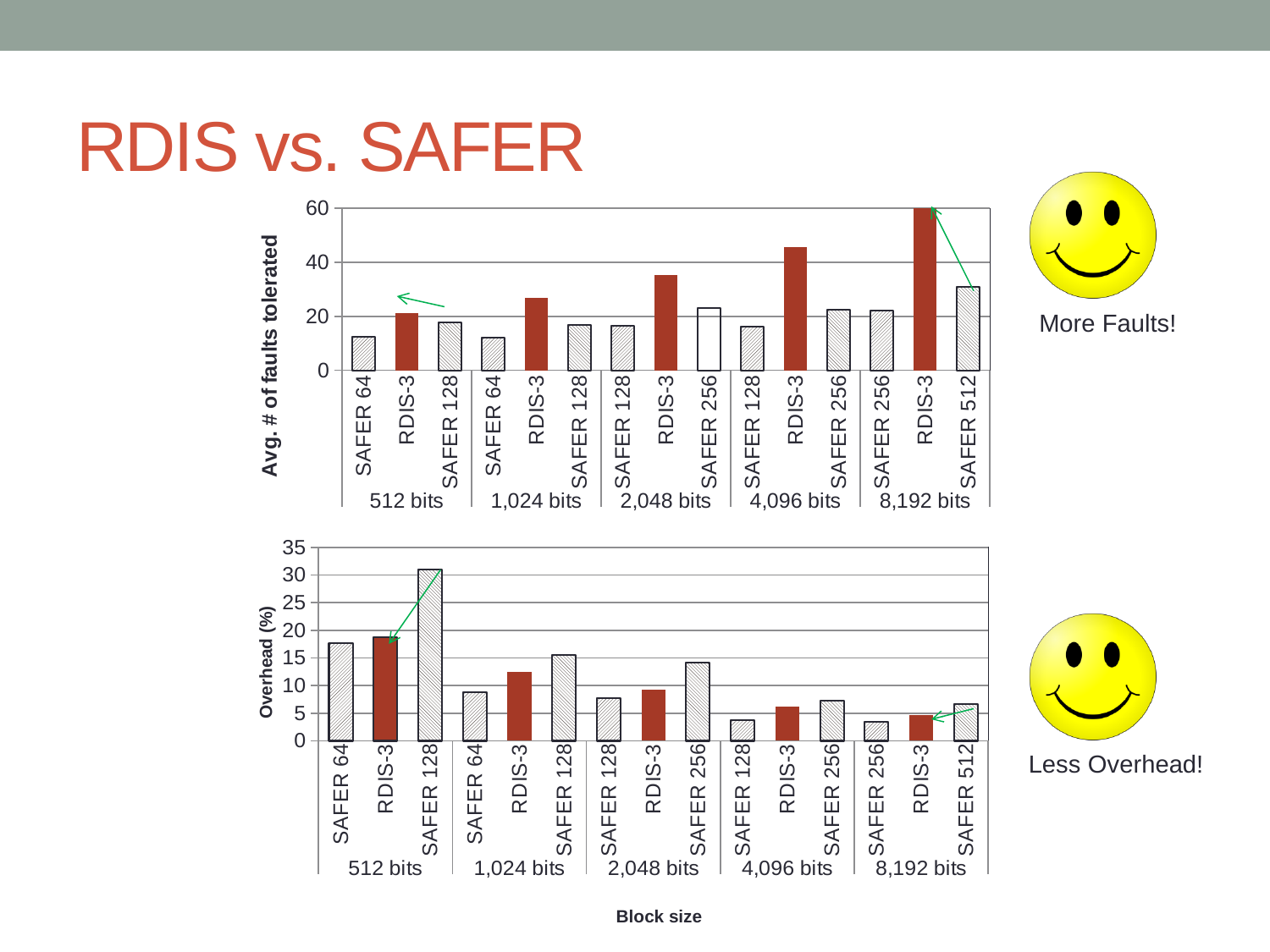
In the top chart (Avg. # of faults tolerated), is the value for SAFER 64 at 512 bits greater or less than 20? less In the top chart (Avg. # of faults tolerated), which bar is the highest? RDIS-3 at 8,192 bits In the bottom chart (Overhead (%)), is the value for SAFER 128 at 512 bits greater or less than 30? greater What kind of chart is the top chart (Avg. # of faults tolerated)? bar chart In the top chart (Avg. # of faults tolerated), which is larger at 2,048 bits: RDIS-3 or SAFER 256? RDIS-3 How many block size groups are shown on the x axis of the bottom chart (Overhead (%))? 5 What is the x-axis title shown below the bottom chart? Block size In the top chart (Avg. # of faults tolerated), is the value for RDIS-3 at 4,096 bits greater or less than 40? greater In the bottom chart (Overhead (%)), which bar is the highest? SAFER 128 at 512 bits In the bottom chart (Overhead (%)), which is larger at 1,024 bits: RDIS-3 or SAFER 128? SAFER 128 In the top chart (Avg. # of faults tolerated), do the RDIS-3 values rise or fall as the block size increases from 512 bits to 8,192 bits? rise